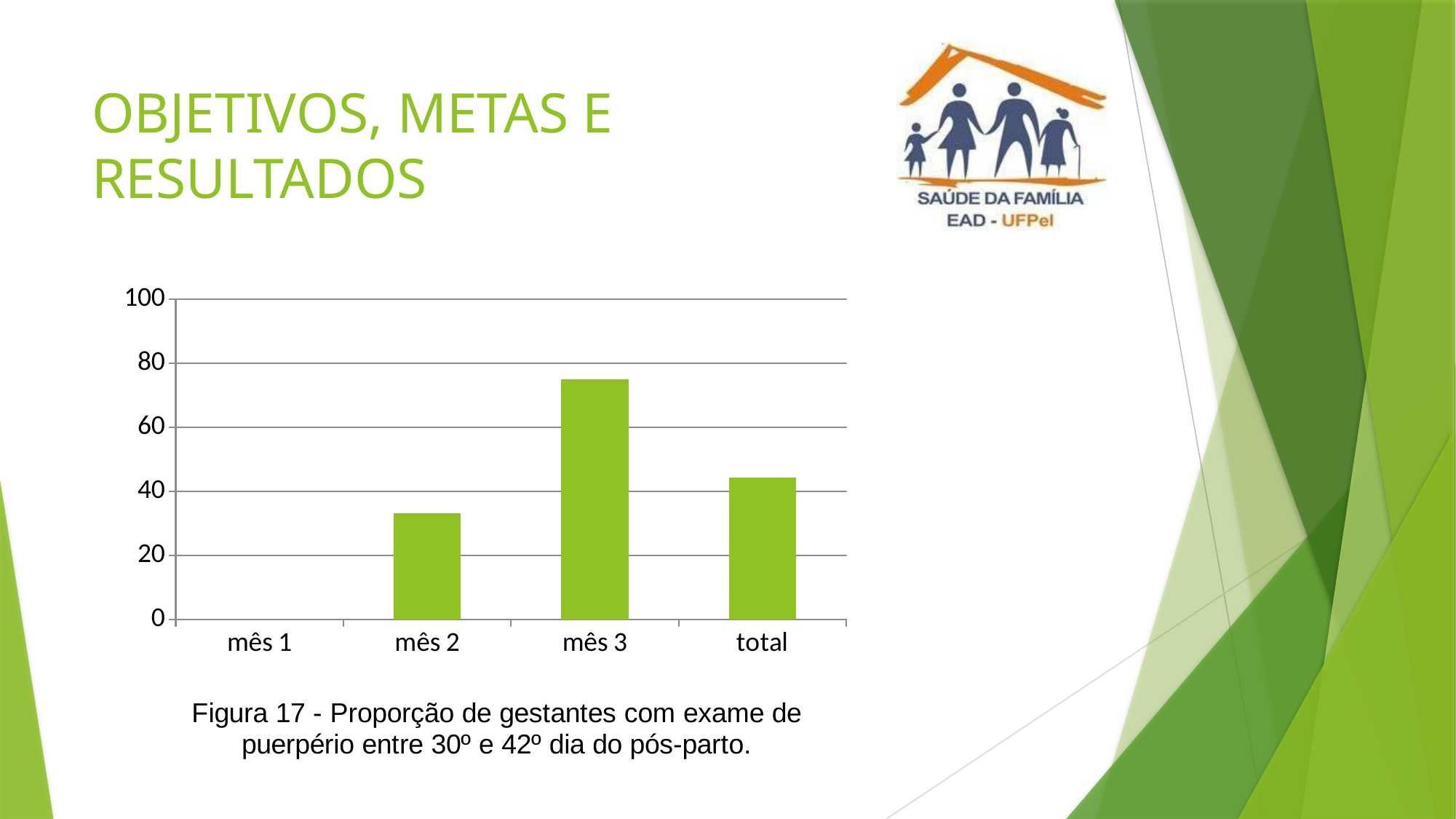
Is the value for mês 2 greater or less than 40? less Is the value for mês 3 greater or less than 60? greater Is the value for mês 2 greater or less than 20? greater Which is larger, the value for mês 3 or the value for total? mês 3 What figure number is given in the caption below the chart? Figura 17 Which category has the lowest value in the chart? mês 1 How many categories are shown on the x axis of the chart? 4 Which category has the highest bar in the chart? mês 3 Do the values rise or fall from mês 1 to mês 3? rise What is the value for mês 1 in the chart? 0 What kind of chart is shown on the slide? bar chart